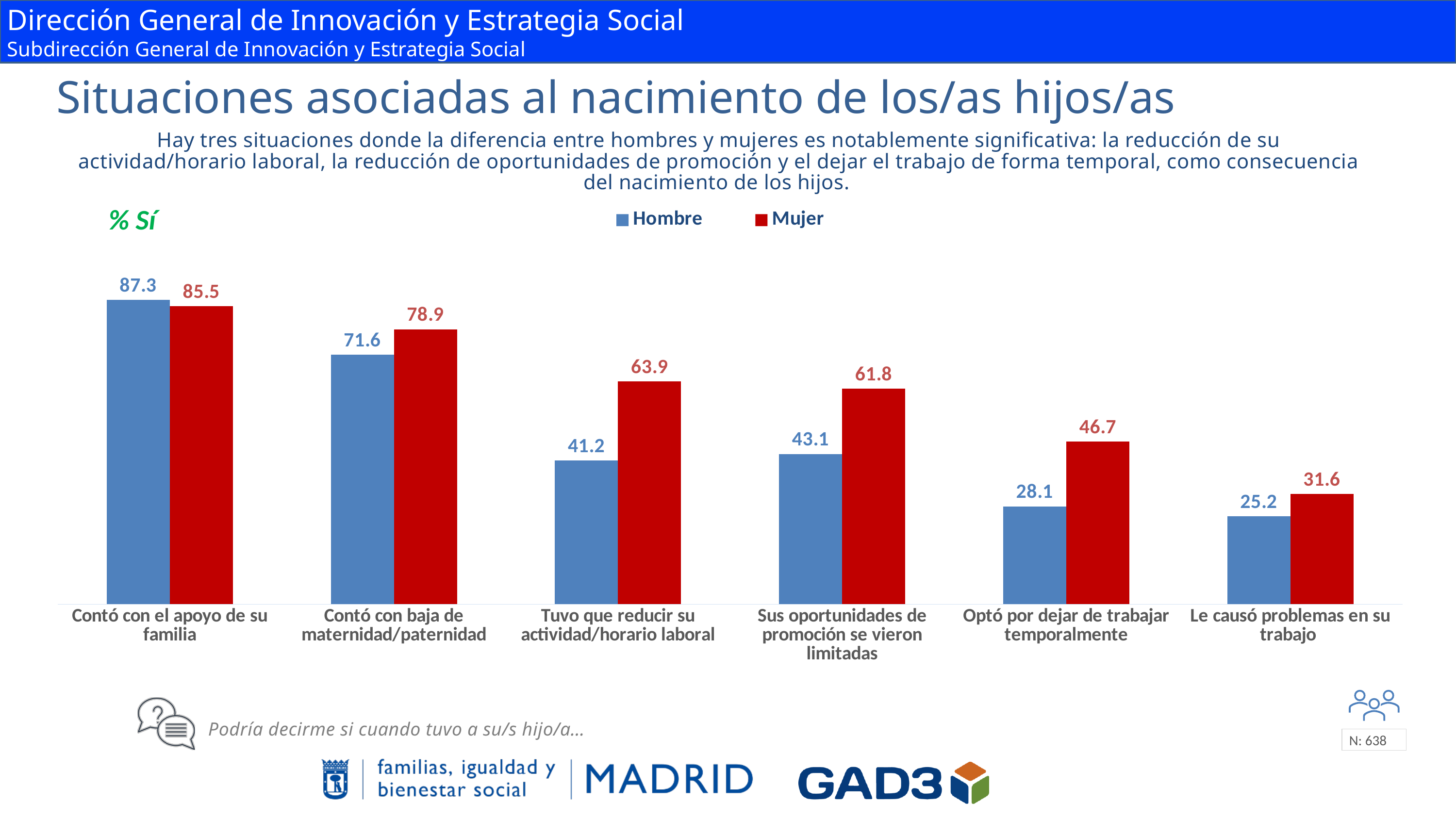
Which category has the lowest Hombre value? Le causó problemas en su trabajo What is the Hombre value for 'Contó con el apoyo de su familia'? 87.3 What is the Mujer value for 'Optó por dejar de trabajar temporalmente'? 46.7 How many categories are shown on the x axis? 6 Which category has the highest Mujer value? Contó con el apoyo de su familia For 'Contó con baja de maternidad/paternidad', which is larger, the Hombre or the Mujer value? Mujer What is the Mujer value for 'Tuvo que reducir su actividad/horario laboral'? 63.9 What kind of chart is shown on the slide? Bar chart What is the difference between the Mujer and Hombre values for 'Tuvo que reducir su actividad/horario laboral'? 22.7 What is the Hombre value for 'Le causó problemas en su trabajo'? 25.2 How many series does the legend list? 2 What is the difference between the Mujer and Hombre values for 'Sus oportunidades de promoción se vieron limitadas'? 18.7